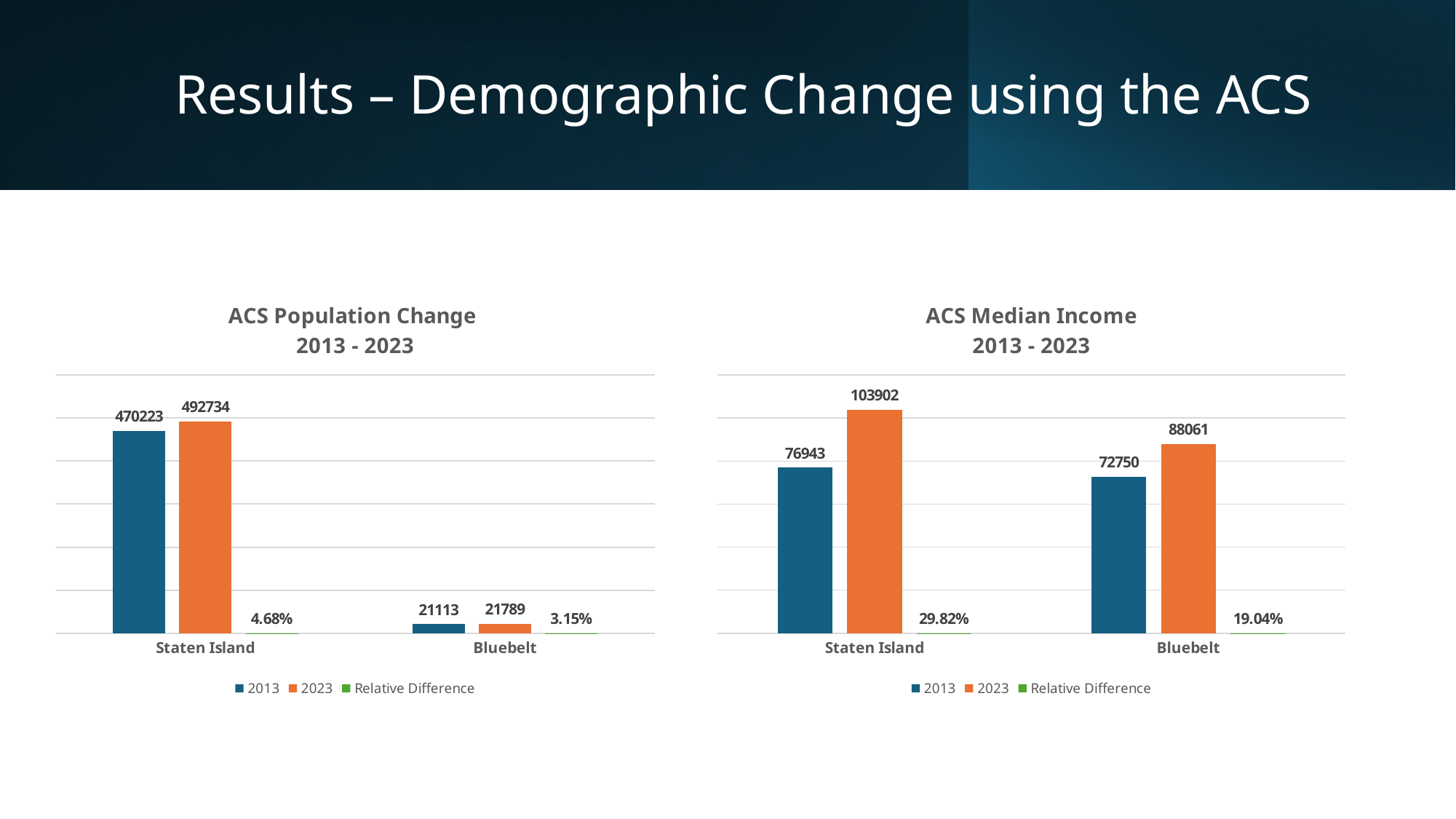
In the ACS Population Change 2013 - 2023 chart, what is the 2013 value for Staten Island? 470223 In the ACS Median Income 2013 - 2023 chart, what is the Relative Difference for Bluebelt? 19.04% In the ACS Median Income 2013 - 2023 chart, what is the difference between the 2023 and 2013 values for Bluebelt? 15311 In the ACS Population Change 2013 - 2023 chart, what is the difference between the 2023 and 2013 values for Staten Island? 22511 In the ACS Population Change 2013 - 2023 chart, which category has the lowest 2013 value? Bluebelt In the ACS Population Change 2013 - 2023 chart, what is the 2023 value for Bluebelt? 21789 In the ACS Median Income 2013 - 2023 chart, what is the 2023 value for Staten Island? 103902 What kind of chart is the ACS Median Income 2013 - 2023 chart? Bar chart How many categories are shown on the x axis of the ACS Population Change 2013 - 2023 chart? 2 In the ACS Population Change 2013 - 2023 chart, what is the Relative Difference for Staten Island? 4.68% In the ACS Median Income 2013 - 2023 chart, which category has the higher 2013 value, Staten Island or Bluebelt? Staten Island How many series does the legend of the ACS Median Income 2013 - 2023 chart list? 3